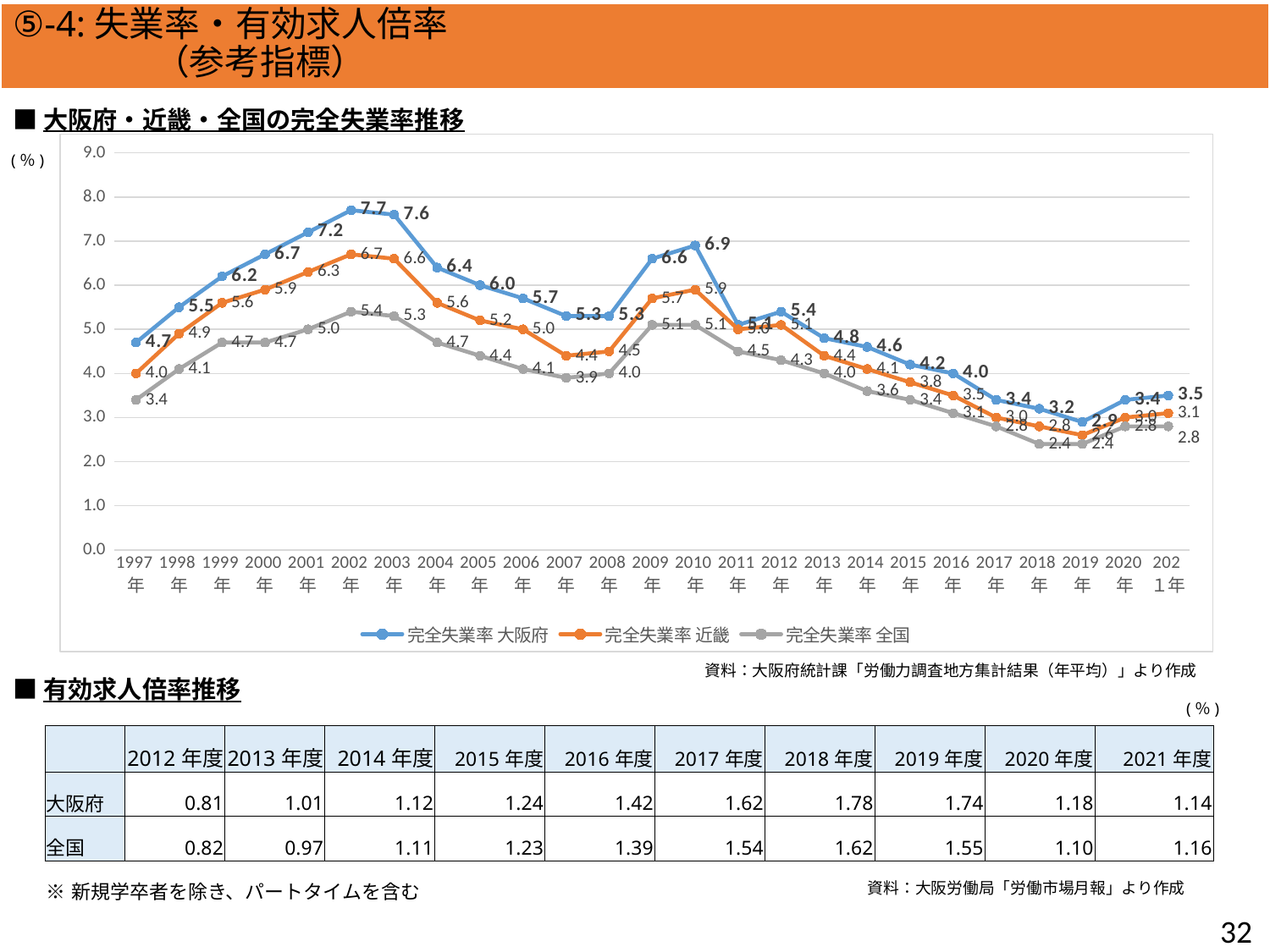
What is the difference between the 完全失業率 for 大阪府 and for 全国 in 2002年? 2.3 What unit is shown on the y axis of the 完全失業率推移 chart? % In which year does the 完全失業率 for 大阪府 reach its highest value? 2002年 What is the 完全失業率 for 大阪府 in 2002年? 7.7 How many years are plotted on the x axis of the 完全失業率推移 chart? 25 In 2021年, which is higher: the 完全失業率 for 大阪府 or for 近畿? 大阪府 How many series does the legend of the 完全失業率推移 chart list? 3 What type of chart is used to show the 完全失業率推移 for 大阪府・近畿・全国? line chart From 2012年 to 2019年, does the 完全失業率 for 大阪府 rise or fall? fall What is the 完全失業率 for 全国 in 2018年? 2.4 What is the 完全失業率 for 近畿 in 2010年? 5.9 In which year is the 完全失業率 for 大阪府 at its lowest? 2019年